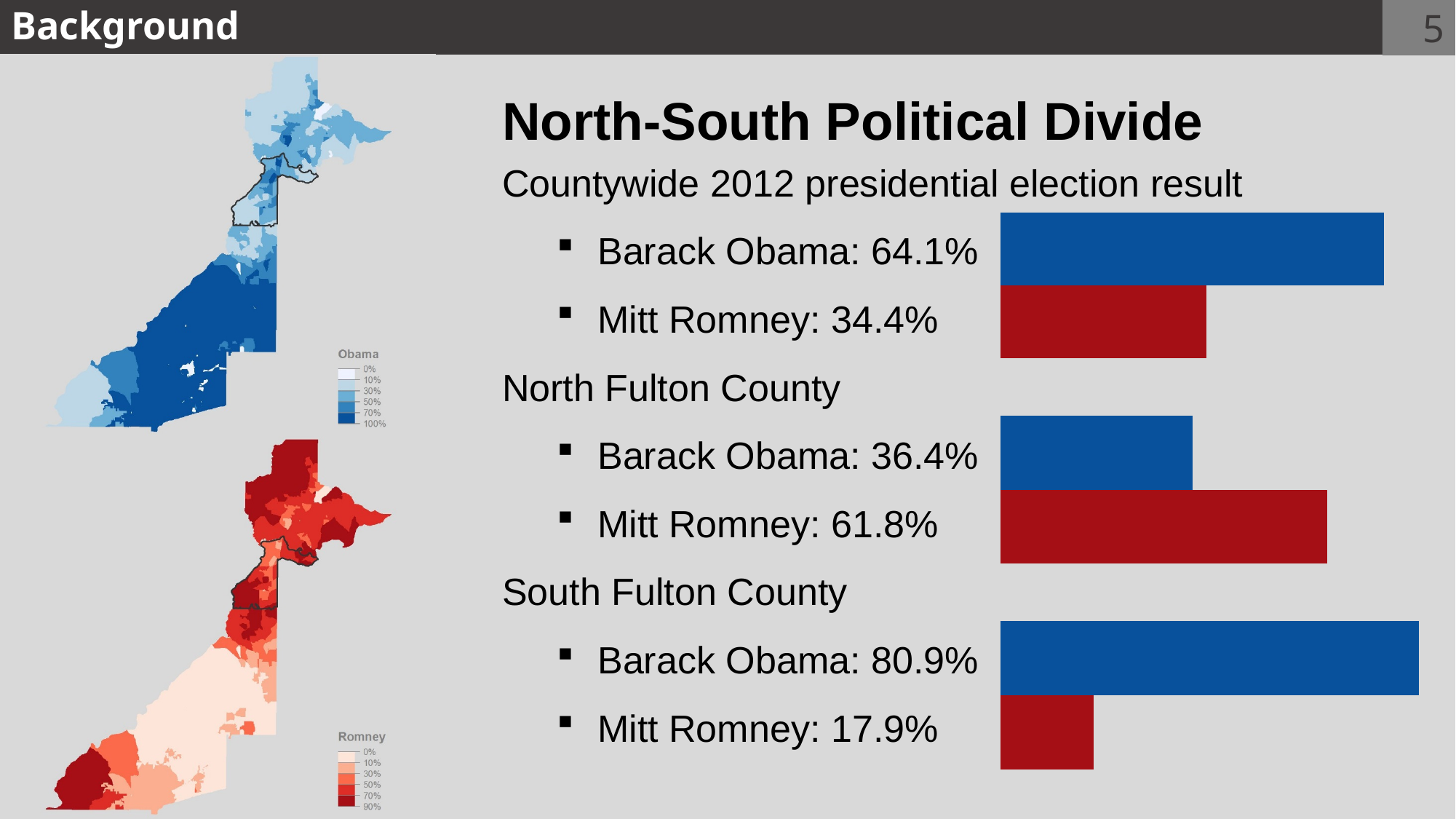
What was Mitt Romney's share in South Fulton County? 17.9% What was Barack Obama's share in South Fulton County? 80.9% What is the difference between Obama's and Romney's shares in North Fulton County? 25.4 percentage points Which of the six bars in the election results chart is the longest? Barack Obama, South Fulton County (80.9%) How many bars are shown in the election results chart? 6 What is the difference between Obama's countywide share and Romney's countywide share? 29.7 percentage points What kind of chart shows the election results on the right side of the slide? bar chart Which of the six bars in the election results chart is the shortest? Mitt Romney, South Fulton County (17.9%) What was Barack Obama's countywide share in the 2012 presidential election? 64.1% What was Mitt Romney's share in North Fulton County? 61.8% In North Fulton County, who received the larger share, Barack Obama or Mitt Romney? Mitt Romney What colour are the bars representing Mitt Romney in the election results chart? red